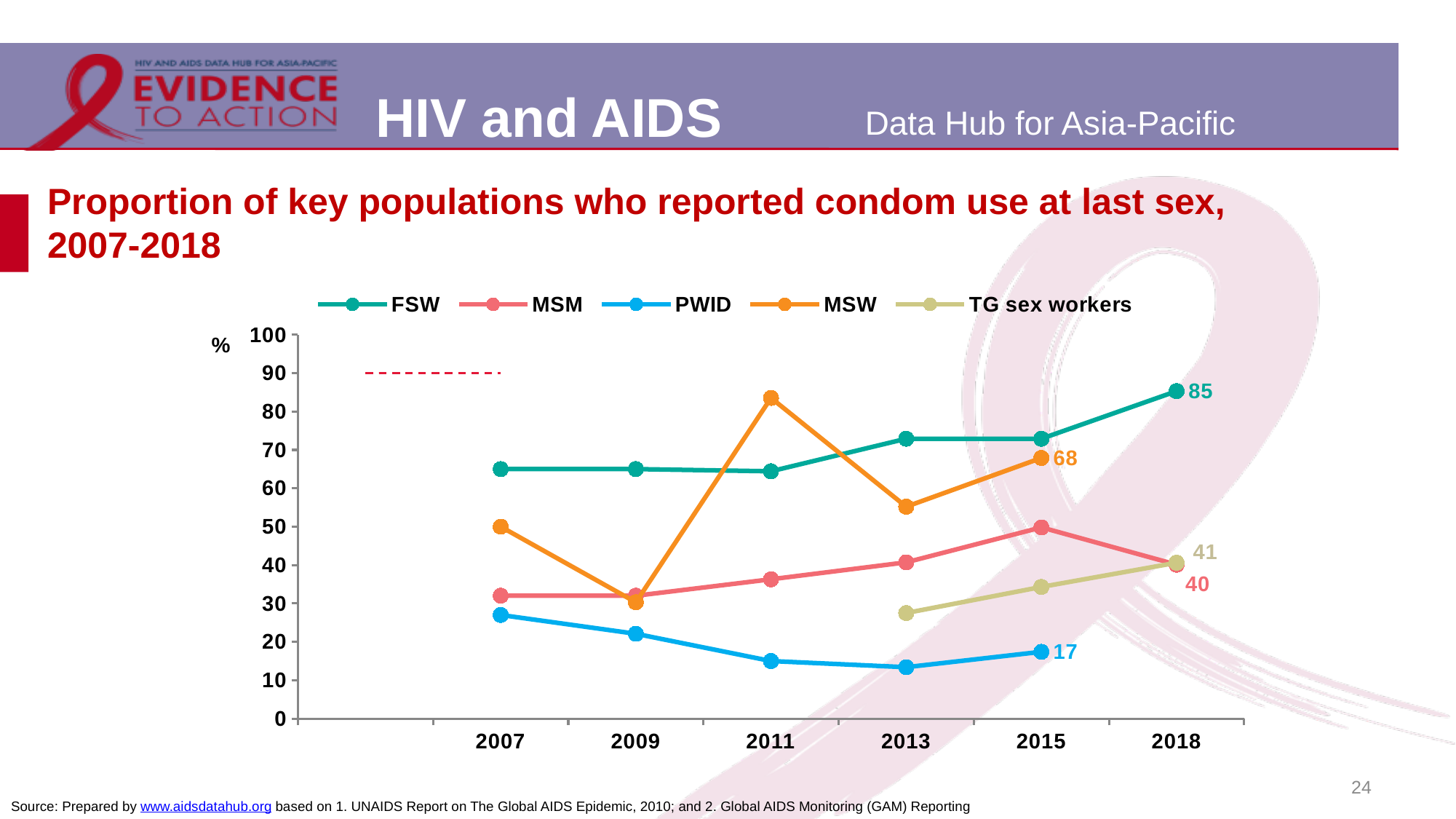
What type of chart is shown on the slide? line chart What is the value for PWID in 2015? 17 Is the value for MSW in 2011 greater or less than 80? greater What is the value for MSW in 2015? 68 What is the value for MSM in 2018? 40 How many years are labelled on the x axis? 6 What is the value for FSW in 2018? 85 Which series has the highest value in 2007? FSW Does the FSW line rise or fall between 2013 and 2018? rise What is the value for TG sex workers in 2018? 41 How many series does the legend list? 5 What is the difference between the FSW value in 2018 and the MSM value in 2018? 45